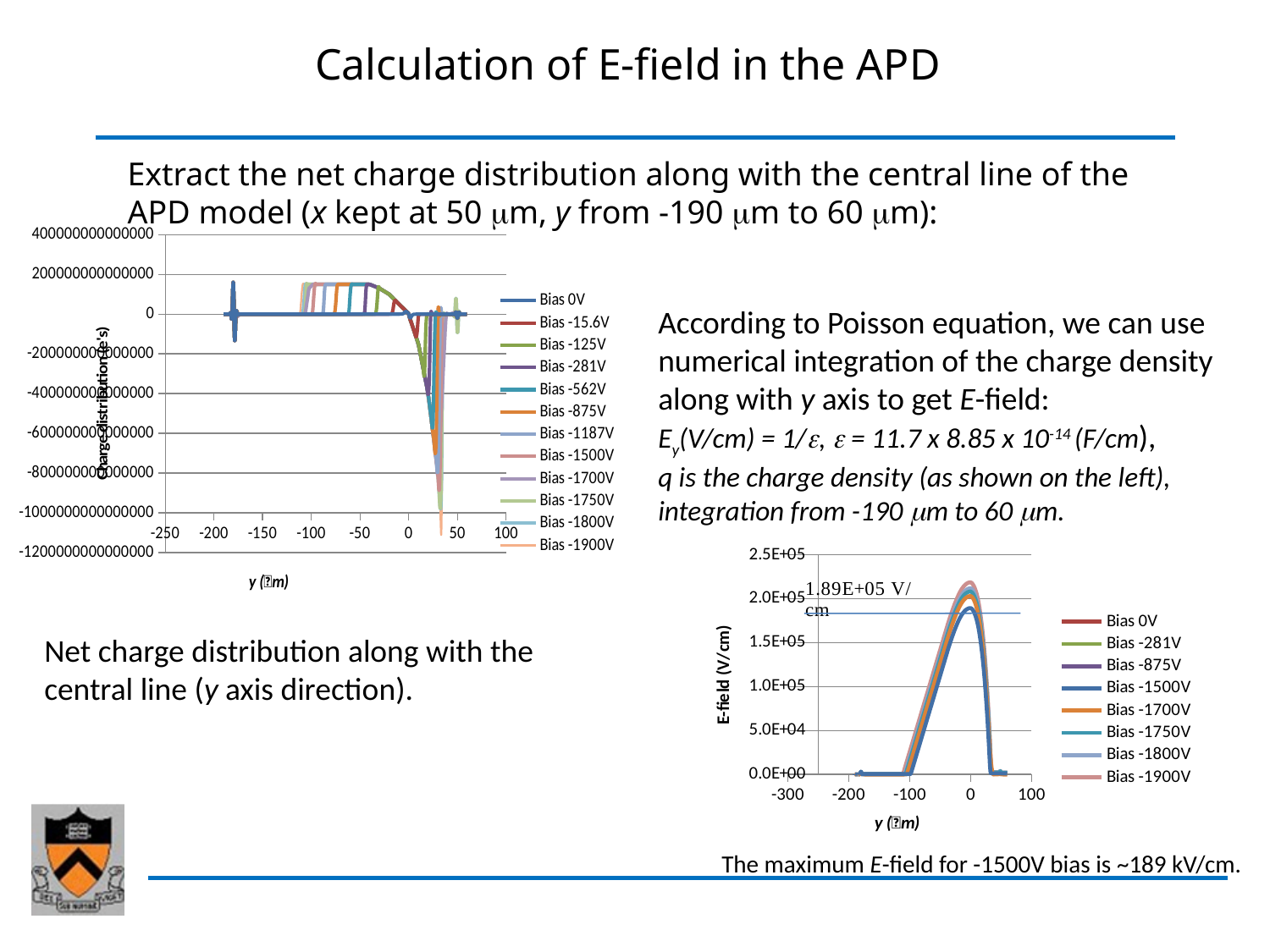
What is the highest tick value on the y axis of the right chart (E-field)? 2.5E+05 What is the lowest tick value on the y axis of the left chart (Charge distribution)? -1200000000000000 What kind of chart is the E-field chart on the right of the slide? line chart How many series does the legend of the left chart (Charge distribution) list? 12 In the left chart (Charge distribution), is the lowest value reached by the curves greater or less than -800000000000000? less How many series does the legend of the right chart (E-field) list? 8 In the right chart (E-field), what peak value is annotated on the plot? 1.89E+05 V/cm In the right chart (E-field), is the peak value of the Bias -1500V series greater or less than 2.0E+05? less In the right chart (E-field), which series reaches a higher peak, Bias -1900V or Bias -1500V? Bias -1900V